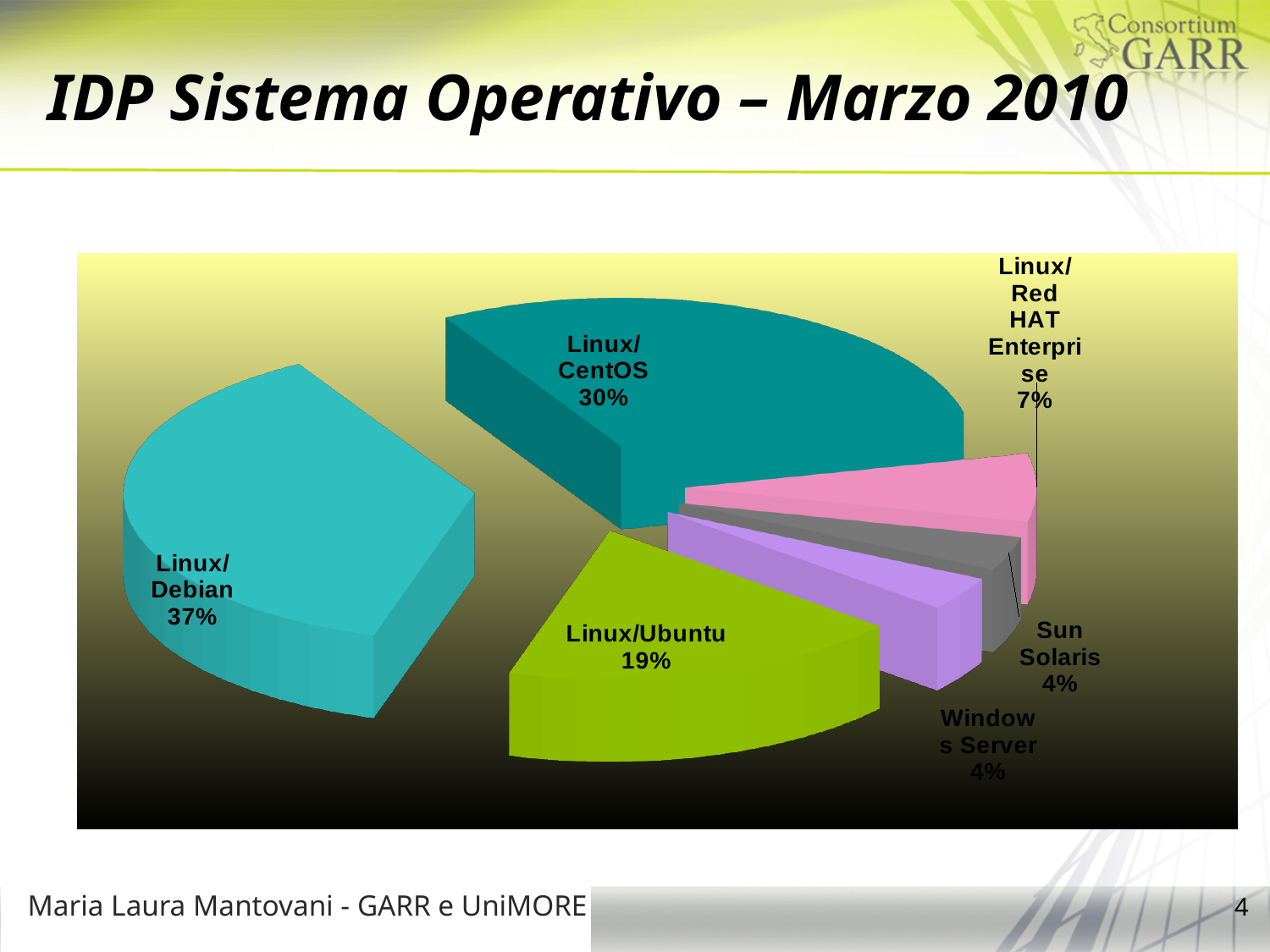
Which is larger, the share for Linux/CentOS or the share for Linux/Ubuntu? Linux/CentOS What is the difference between the shares of Linux/Ubuntu and Linux/Red HAT Enterprise? 12% What kind of chart is shown on the slide? Pie chart What is the difference between the shares of Linux/Debian and Linux/CentOS? 7% How many slices does the pie chart have? 6 What is the value shown for Linux/Red HAT Enterprise? 7% Which operating system has the largest slice of the pie? Linux/Debian What is the value shown for Sun Solaris? 4% What is the title of the slide containing the chart? IDP Sistema Operativo – Marzo 2010 What is the value shown for Linux/Ubuntu? 19% What share of the pie does Linux/Debian have? 37% What share of the pie does Linux/CentOS have? 30%